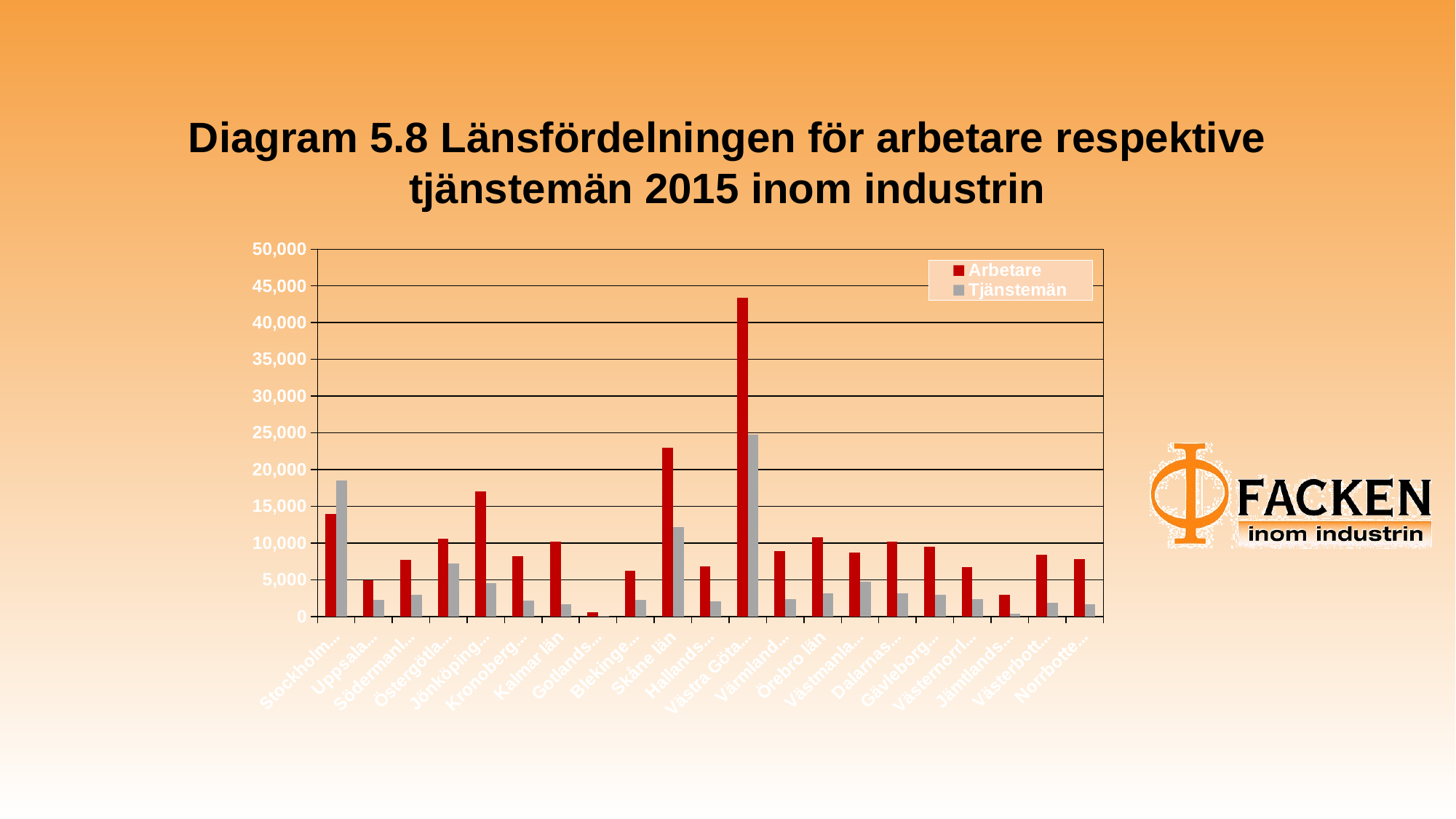
Which colour represents the Arbetare series in the legend? Red Which county has the lowest Arbetare value? Gotland How many series does the legend list? 2 For Skåne län, which is larger: Arbetare or Tjänstemän? Arbetare Is the Tjänstemän value for Stockholm greater or less than 15,000? greater What kind of chart is shown on the slide? Bar chart How many counties (categories) are plotted along the x axis? 21 Which county has the highest Arbetare value? Västra Götaland For Stockholm, which is larger: Arbetare or Tjänstemän? Tjänstemän Which county has the highest Tjänstemän value? Västra Götaland Is the Arbetare value for Skåne län greater or less than 20,000? greater Is the Arbetare value for Västra Götaland greater or less than 40,000? greater